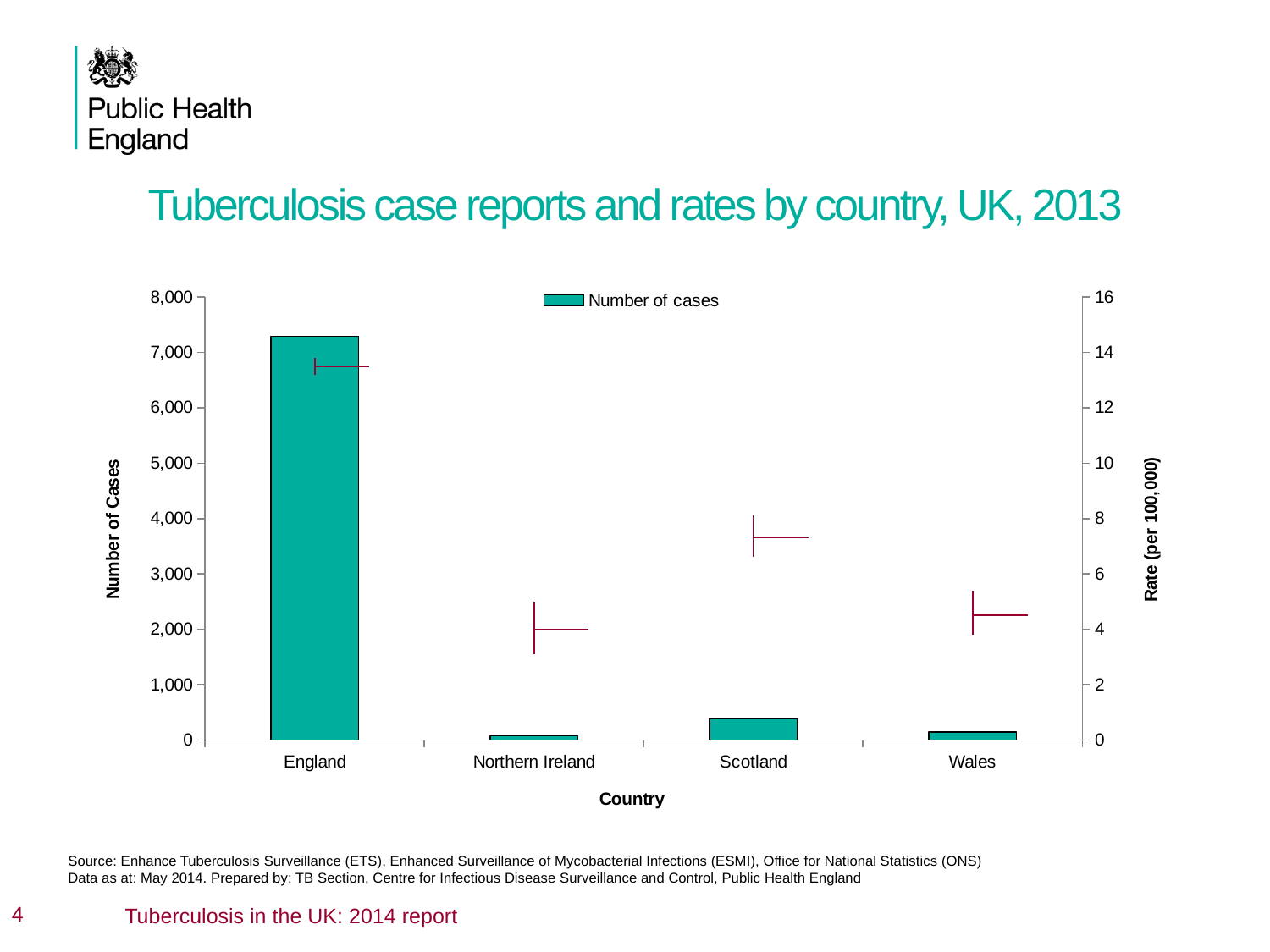
What is the title of the chart? Tuberculosis case reports and rates by country, UK, 2013 What is the label of the right-hand vertical axis? Rate (per 100,000) How many countries are shown on the x axis of the chart? 4 Which has more cases, Scotland or Wales? Scotland Which country has the highest number of cases? England Is the number of cases for England greater or less than 7,000? greater Which has more cases, England or Scotland? England Is the number of cases for Scotland greater or less than 1,000? less What kind of chart is shown on the slide? Bar chart Is the number of cases for Wales greater or less than 1,000? less How many series does the chart's legend list? 1